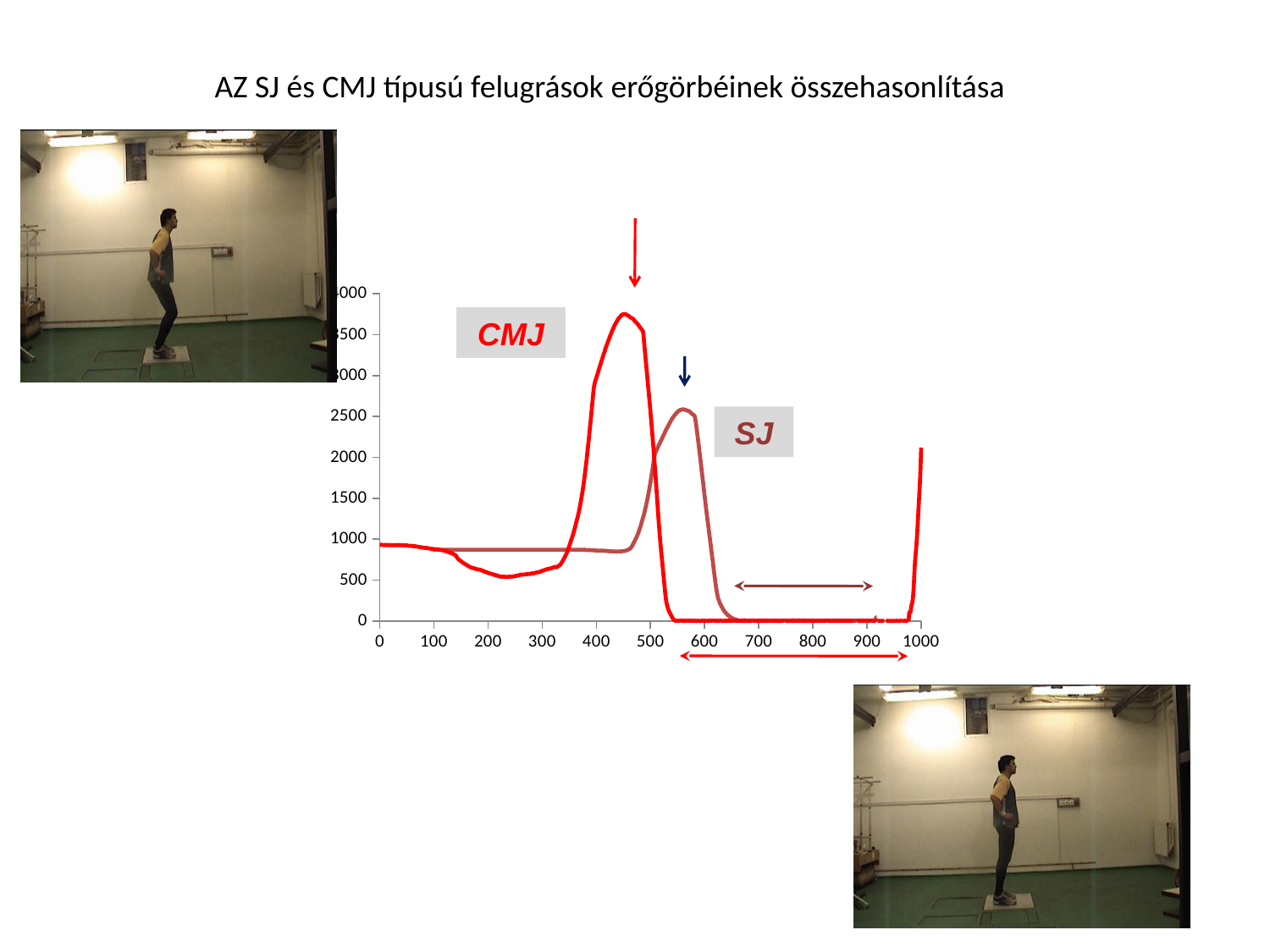
Is the lowest value of the CMJ curve between x = 100 and x = 300 greater or less than 1000? less What is the highest value shown on the y axis of the chart? 4000 Is the value of the CMJ curve at x = 0 greater or less than 1000? less What are the two series labelled on the chart? CMJ and SJ Which curve reaches the higher peak value, CMJ or SJ? CMJ Is the peak value of the SJ curve greater or less than 2000? greater What is the title of the slide containing the chart? AZ SJ és CMJ típusú felugrások erőgörbéinek összehasonlítása What kind of chart is shown on the slide? line chart How many curves (series) are plotted on the chart? 2 Which curve reaches its peak earlier along the x axis, CMJ or SJ? CMJ